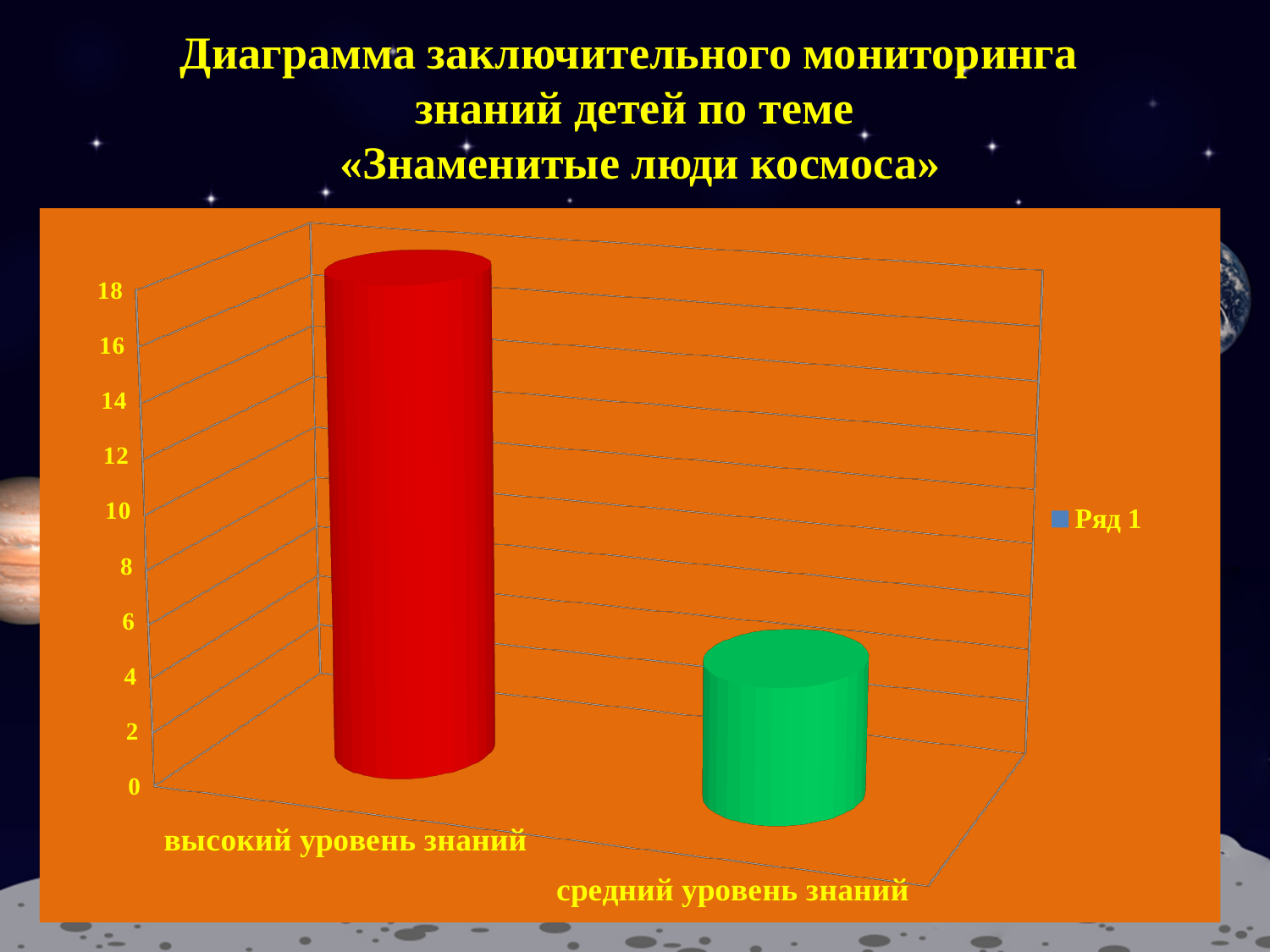
Which category has the highest value? высокий уровень знаний What is the name of the series shown in the legend? Ряд 1 Is the value for средний уровень знаний greater or less than 10? less Is the value for средний уровень знаний greater or less than 8? less What colour is the bar for средний уровень знаний? green Is the value for высокий уровень знаний greater or less than 14? greater How many series does the legend list? 1 Which category has the lowest value? средний уровень знаний How many categories are plotted in the chart? 2 Which is larger: the value for высокий уровень знаний or the value for средний уровень знаний? высокий уровень знаний What kind of chart is shown on the slide? bar chart